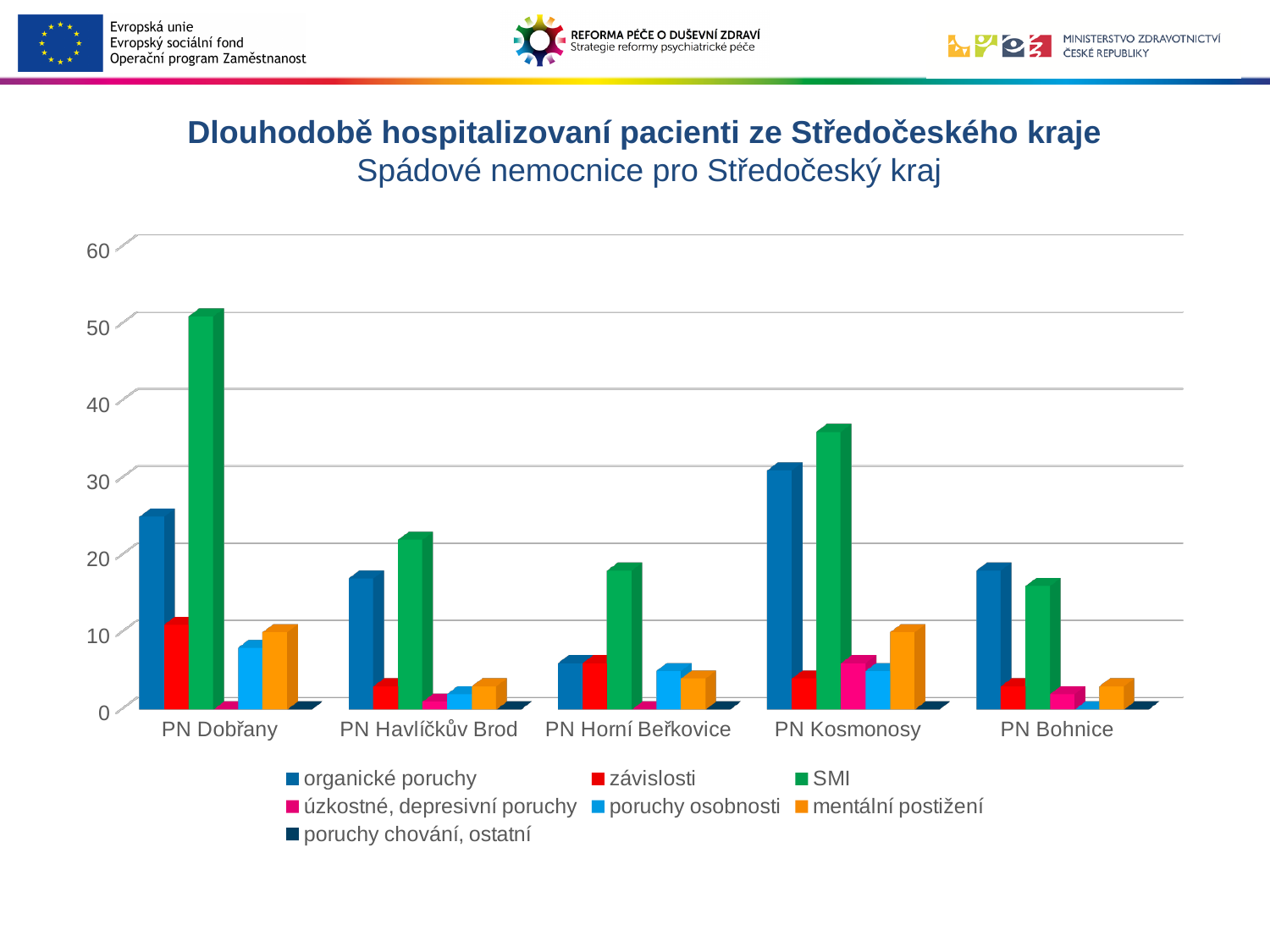
What is the main title of the chart on the slide? Dlouhodobě hospitalizovaní pacienti ze Středočeského kraje How many hospitals (categories) are shown on the x axis? 5 What kind of chart is shown on the slide? bar chart Which hospital has the highest value for SMI? PN Dobřany Is the value for SMI at PN Havlíčkův Brod greater or less than 30? less Which is larger at PN Dobřany: závislosti or SMI? SMI How many series does the legend list? 7 Is the value for organické poruchy at PN Dobřany greater or less than 20? greater Which hospital has the lowest value for organické poruchy? PN Horní Beřkovice Which is larger at PN Kosmonosy: organické poruchy or SMI? SMI